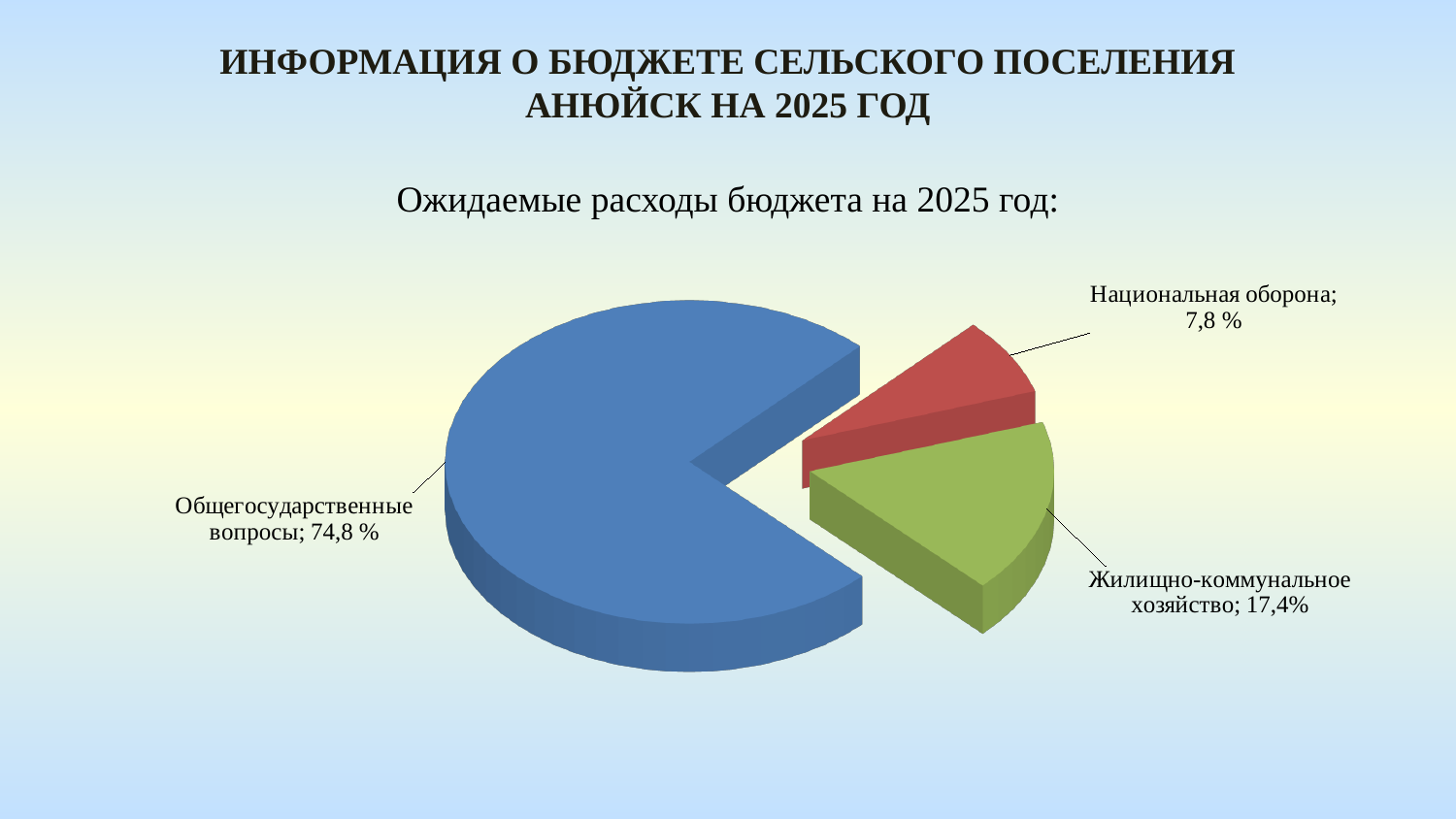
What share of expected 2025 budget expenditure goes to Жилищно-коммунальное хозяйство? 17,4% How many slices does the pie chart have? 3 Which is larger: the share for Жилищно-коммунальное хозяйство or the share for Национальная оборона? Жилищно-коммунальное хозяйство What is the subtitle above the pie chart? Ожидаемые расходы бюджета на 2025 год: What kind of chart is shown on the slide? pie chart Which category has the smallest share of the pie? Национальная оборона By how many percentage points does the share for Общегосударственные вопросы exceed the share for Жилищно-коммунальное хозяйство? 57,4 What share of expected 2025 budget expenditure goes to Национальная оборона? 7,8 % What colour is the slice for Общегосударственные вопросы? blue What share of expected 2025 budget expenditure goes to Общегосударственные вопросы? 74,8 % By how many percentage points does the share for Жилищно-коммунальное хозяйство exceed the share for Национальная оборона? 9,6 Which category has the largest share of the pie? Общегосударственные вопросы